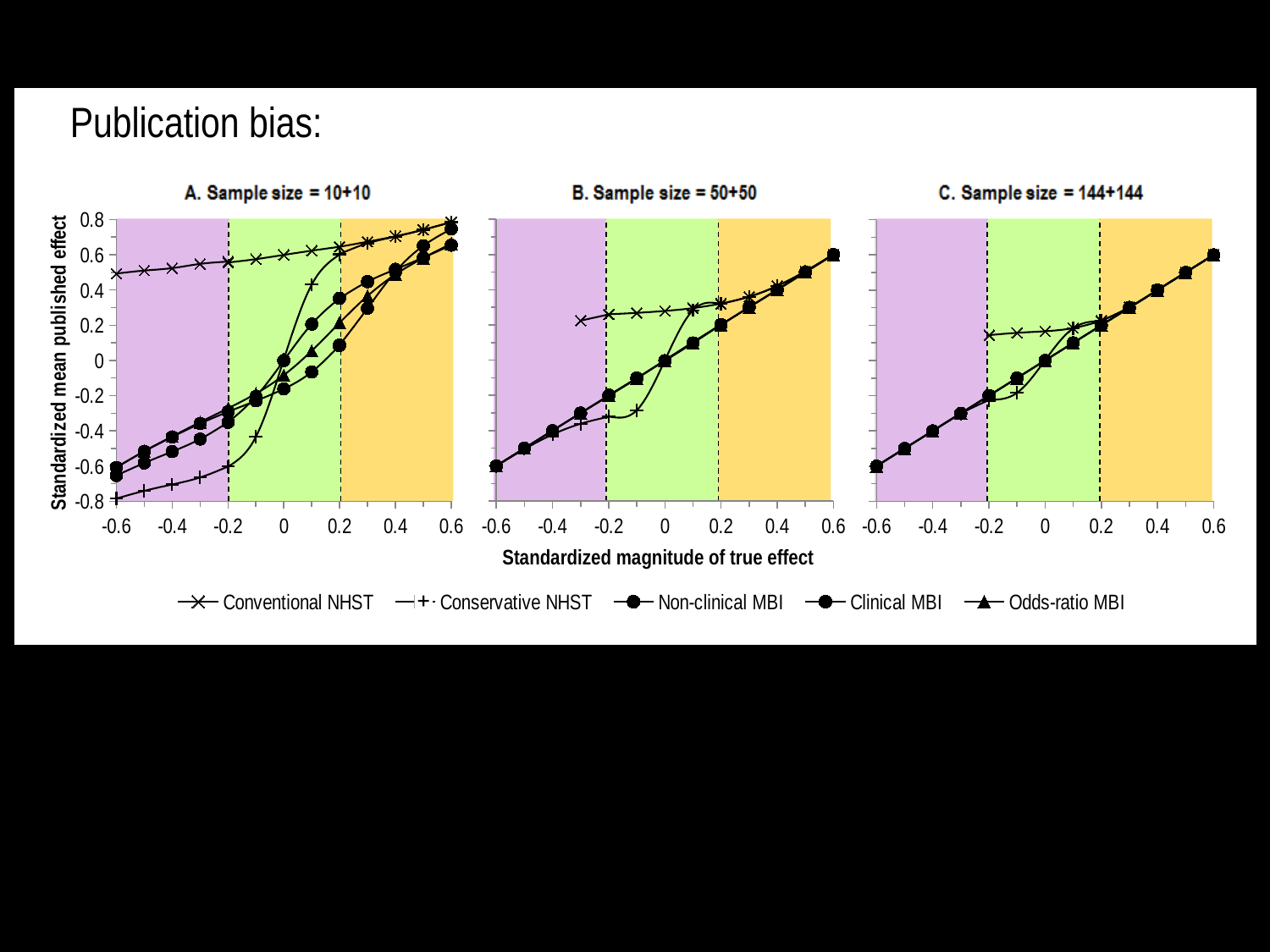
How many series does the legend list for the charts? 5 In panel A (Sample size = 10+10), which is higher at a true effect of 0: Conventional NHST or Clinical MBI? Conventional NHST In panel C (Sample size = 144+144), does the Non-clinical MBI line rise or fall as the true effect increases from -0.6 to 0.6? rise In panel A (Sample size = 10+10), is the Conservative NHST value at a true effect of -0.6 greater or less than -0.6? less In panel A (Sample size = 10+10), is the Conventional NHST value at a true effect of 0.6 greater or less than 0.6? greater In panel B (Sample size = 50+50), is the Conventional NHST value at a true effect of -0.2 greater or less than 0? greater What kind of chart is shown in panel A (Sample size = 10+10)? line chart How many chart panels are shown on the slide? 3 What is the label of the shared vertical axis of the charts? Standardized mean published effect In panel A (Sample size = 10+10), which is higher at a true effect of -0.6: Conventional NHST or Conservative NHST? Conventional NHST What is the title of the rightmost chart panel? C. Sample size = 144+144